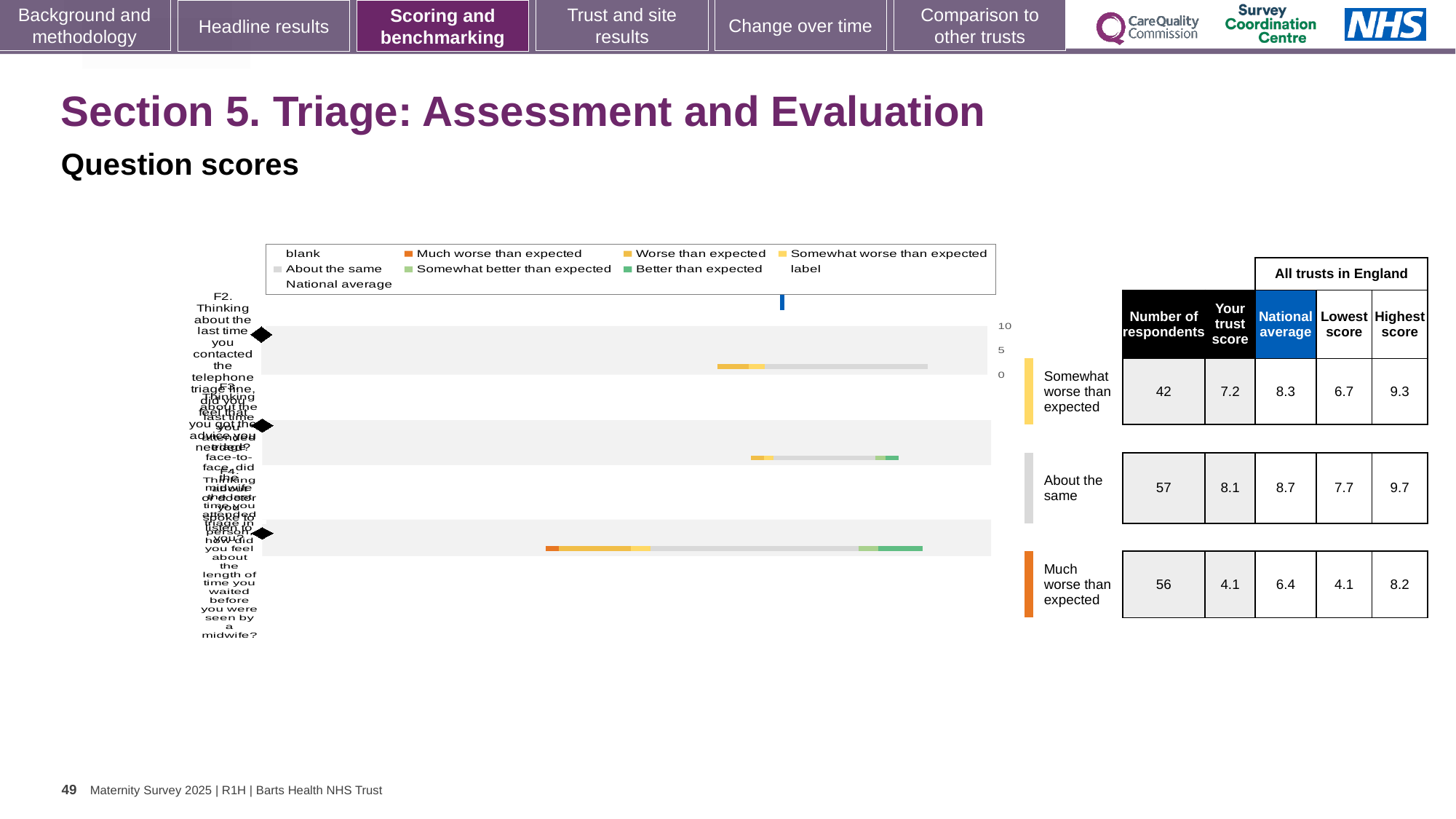
Is the trust score marker on the bottom bar of the chart greater or less than 5? less What is the highest tick value shown on the chart's score axis? 10 What kind of chart is shown on the left of the slide? bar chart In the table, what is the national average for the 'Much worse than expected' row? 6.4 Which row in the table has the lowest 'Your trust score'? Much worse than expected How many question bars are plotted in the chart? 3 In the table, what is the number of respondents for the 'Somewhat worse than expected' row? 42 Which row in the table has the highest 'Your trust score'? About the same In the table, what is the difference between the national average and 'Your trust score' for the 'Much worse than expected' row? 2.3 In the table, what is 'Your trust score' for the 'About the same' row? 8.1 In the table, what is the highest score for the 'About the same' row? 9.7 In the chart legend, what colour represents 'Much worse than expected'? orange